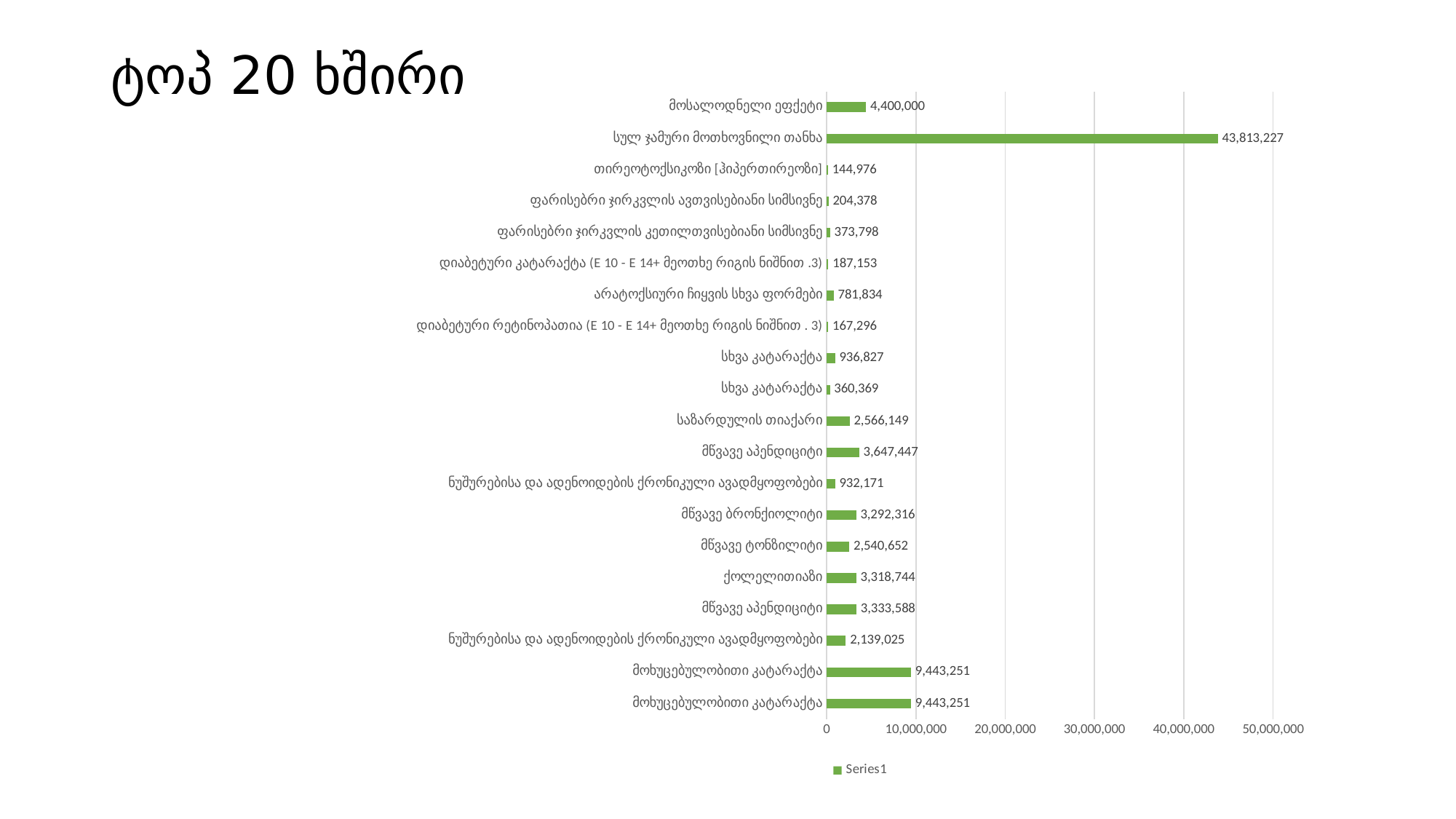
Which category has the highest value? სულ ჯამური მოთხოვნილი თანხა How many categories are plotted in the chart? 20 What is the value for ქოლელითიაზი? 3,318,744 What is the difference between the values for მწვავე ბრონქიოლიტი and მწვავე ტონზილიტი? 751,664 What is the value for სულ ჯამური მოთხოვნილი თანხა? 43,813,227 Is the value for სულ ჯამური მოთხოვნილი თანხა greater or less than 40,000,000? greater What is the name of the series shown in the legend? Series1 Which is larger, the value for არატოქსიური ჩიყვის სხვა ფორმები or the value for ფარისებრი ჯირკვლის კეთილთვისებიანი სიმსივნე? არატოქსიური ჩიყვის სხვა ფორმები What is the value for საზარდულის თიაქარი? 2,566,149 What type of chart is shown on the slide? bar chart Which category has the lowest value? თირეოტოქსიკოზი [ჰიპერთირეოზი] What is the value for მოსალოდნელი ეფექტი? 4,400,000